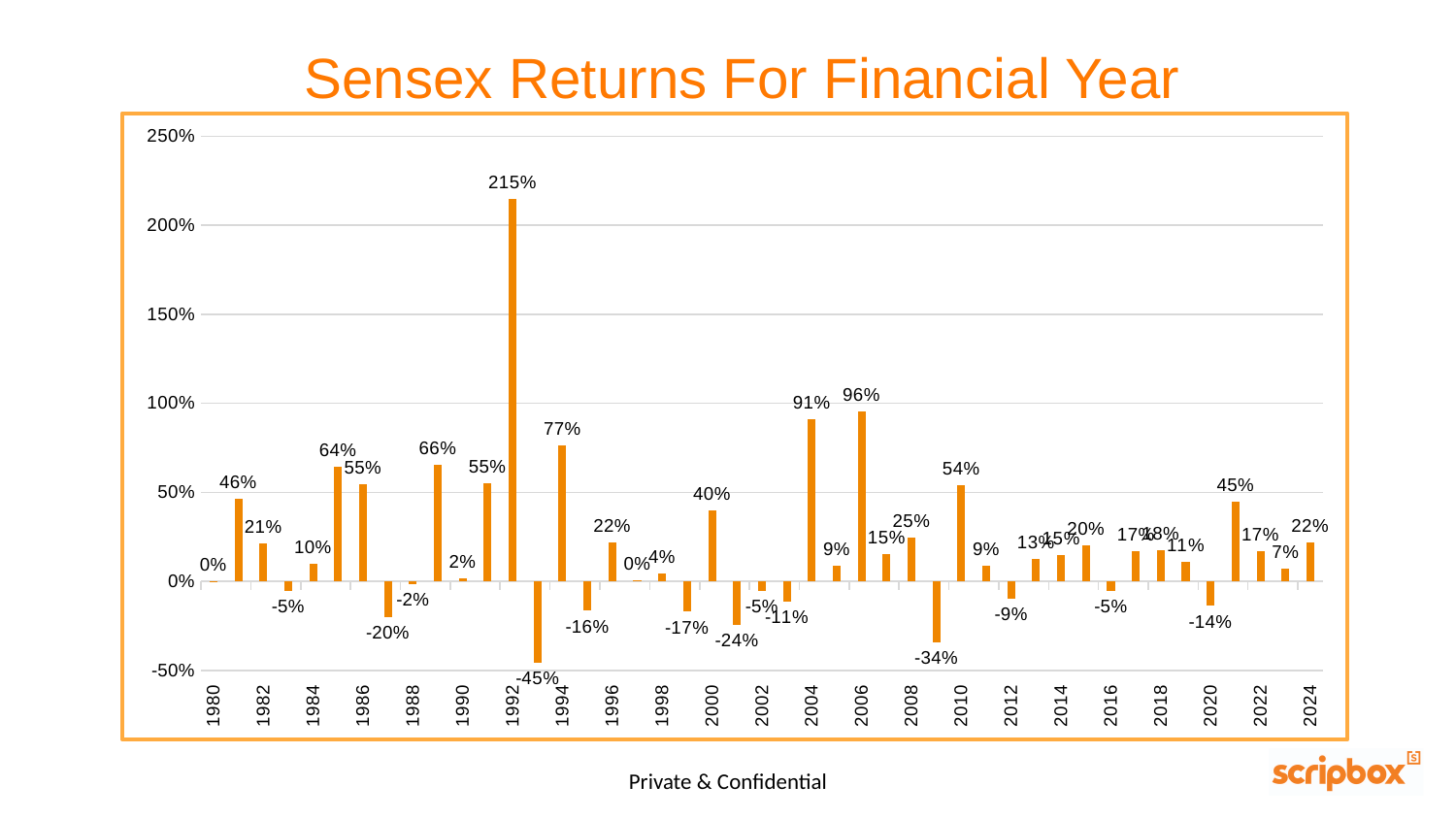
What is the difference between the Sensex returns for 2006 and 2004? 5% What is the lowest Sensex return shown on the chart? -45% What type of chart is shown on the slide? Bar chart What is the Sensex return for financial year 2010? 54% What is the Sensex return for financial year 2024? 22% Is the Sensex return for 1994 greater or less than 50%? greater What is the highest value shown on the vertical axis? 250% What is the Sensex return for financial year 2020? -14% What is the title of the chart? Sensex Returns For Financial Year Which financial year has the highest Sensex return? 1992 Which financial year has the larger Sensex return, 2000 or 2010? 2010 What is the Sensex return for financial year 1992? 215%